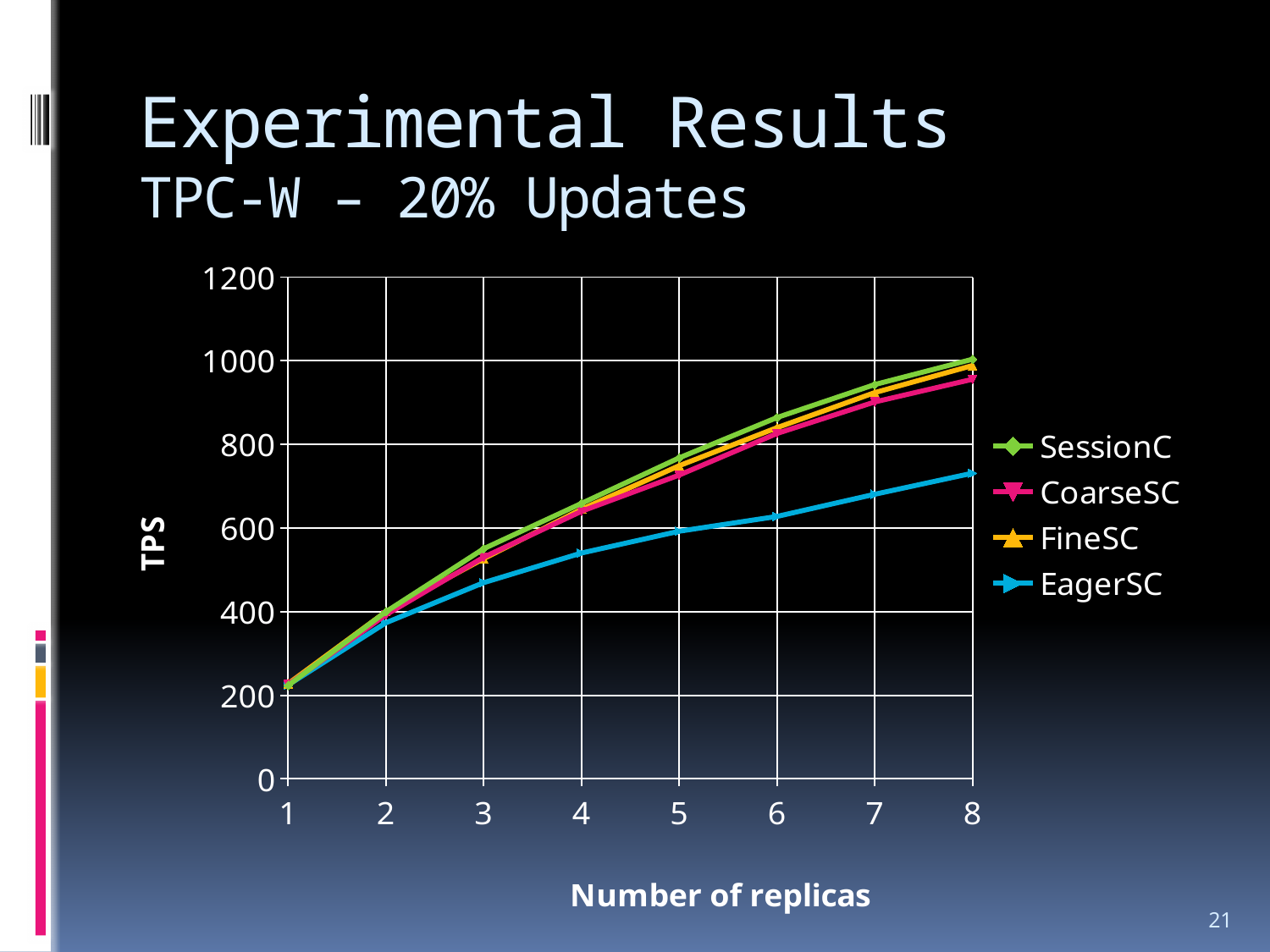
Which series has the lowest TPS at 8 replicas? EagerSC Is the TPS value for SessionC at 8 replicas greater or less than 800? greater What kind of chart is shown on the slide? line chart Is the TPS value for EagerSC at 4 replicas greater or less than 600? less What is the label of the x axis? Number of replicas Is the TPS value for CoarseSC at 1 replica greater or less than 400? less At 8 replicas, which is larger: the TPS for SessionC or for EagerSC? SessionC How many values of Number of replicas are plotted along the x axis? 8 What is the label of the y axis? TPS How many series does the legend list? 4 Do the TPS values rise or fall as the number of replicas increases? rise